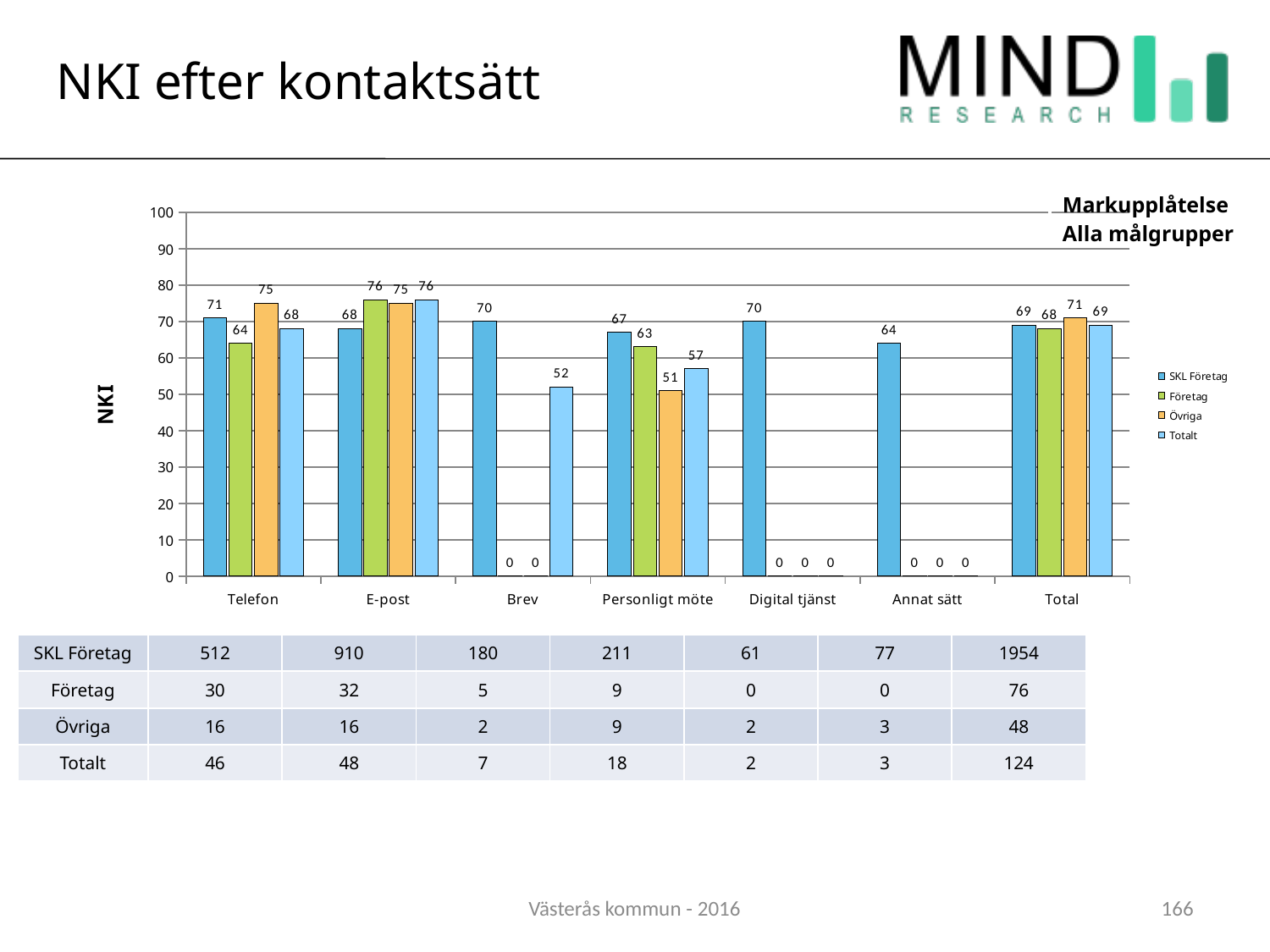
Which category has the lowest Övriga value among those with a non-zero value? Personligt möte What is the NKI value for Övriga in the Telefon category? 75 What is the label on the vertical axis of the chart? NKI How many series does the chart legend list? 4 What is the difference between the SKL Företag value and the Totalt value in the Personligt möte category? 10 Is the Totalt value for Brev greater or less than 60? less How many categories are shown on the x axis of the chart? 7 Which category has the highest Företag value? E-post Which is larger, the Företag value for Telefon or the Företag value for E-post? E-post What is the NKI value for SKL Företag in the Digital tjänst category? 70 What is the NKI value for Totalt in the Brev category? 52 What kind of chart is shown on the slide? bar chart